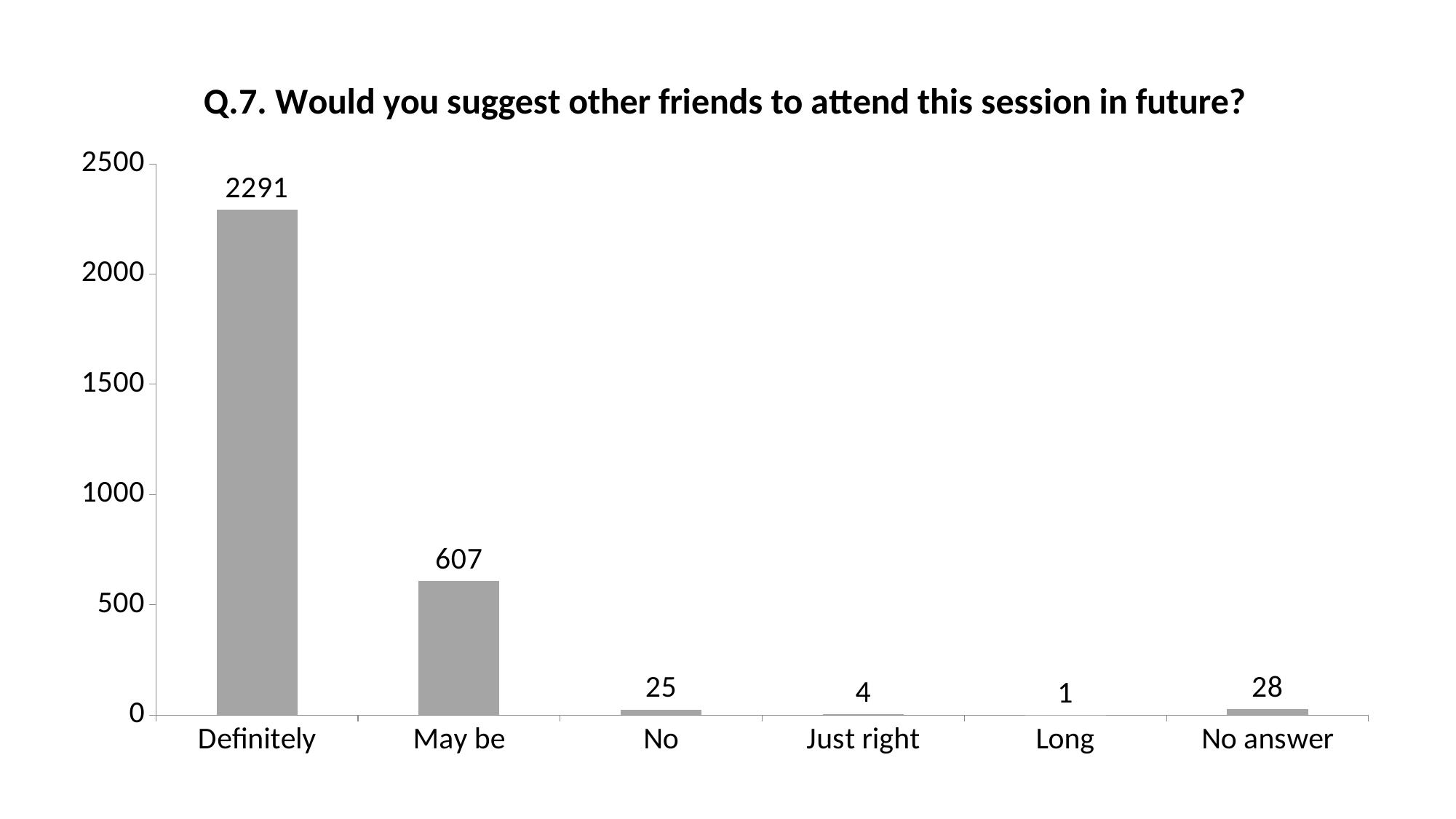
What is the value for Just right? 4 What kind of chart is this? bar chart How many categories are shown on the x axis? 6 Which category has the lowest value? Long What is the value for May be? 607 Which is larger, the value for No or the value for No answer? No answer What is the difference between the values for Definitely and May be? 1684 What is the value for No answer? 28 Is the value for May be greater or less than 1000? less Which category has the highest value? Definitely What is the value for Definitely? 2291 What is the title of the chart? Q.7. Would you suggest other friends to attend this session in future?